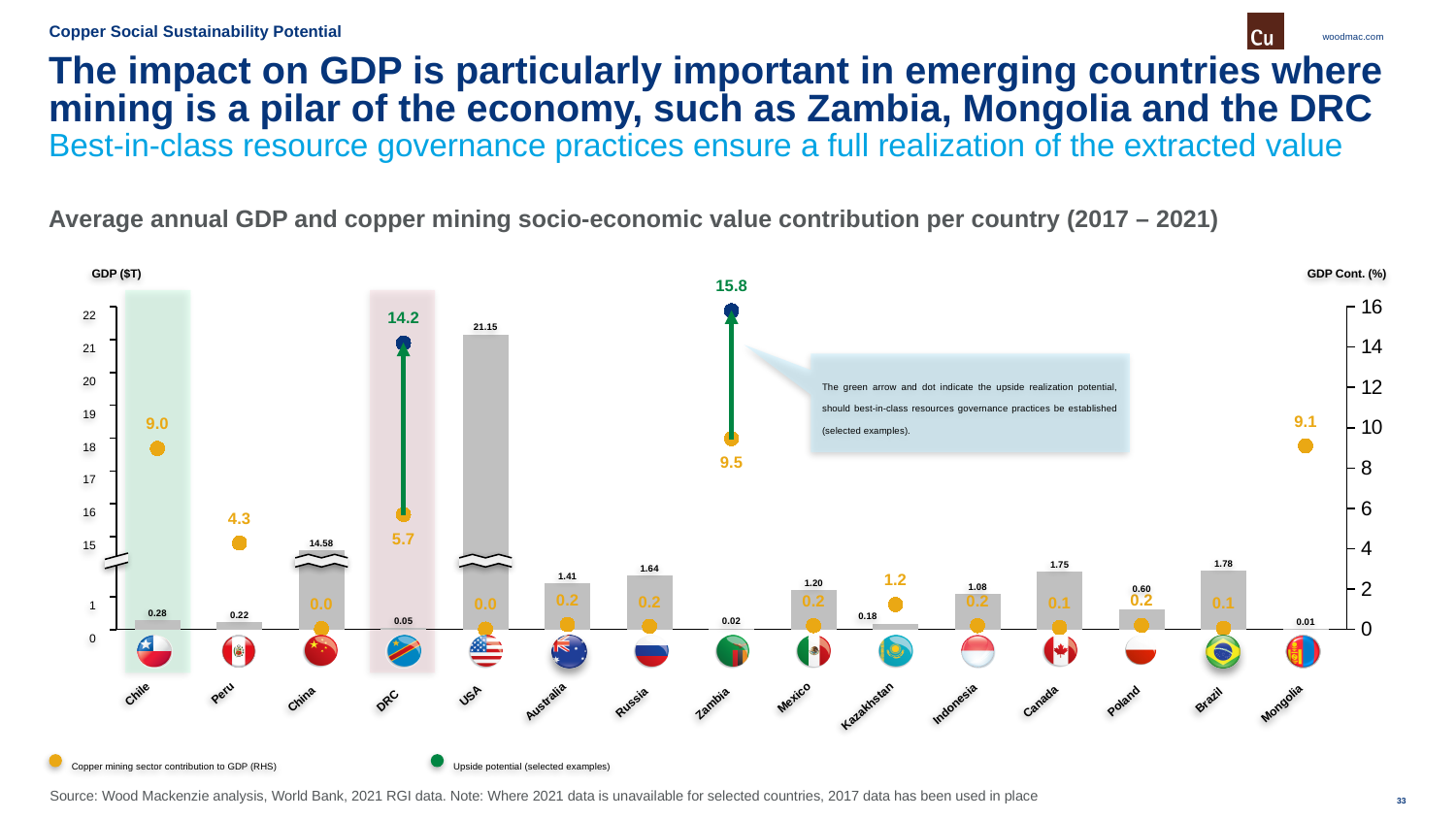
What is the copper mining sector contribution to GDP (%) shown for Peru? 4.3 What is the copper mining sector contribution to GDP (%) shown for Mongolia? 9.1 How many entries does the chart legend list? 2 What is the average annual GDP ($T) shown for the USA? 21.15 Which country has the lowest GDP ($T) bar? Mongolia What is the difference between Zambia's upside potential (15.8) and its current copper mining contribution to GDP (9.5)? 6.3 Which country has the highest GDP ($T) bar? USA What is the difference between the DRC's upside potential (14.2) and its current copper mining contribution to GDP (5.7)? 8.5 Which has the larger GDP ($T) bar, China or the USA? USA Which country has the highest current copper mining sector contribution to GDP (orange dot)? Zambia What is the GDP ($T) value shown for Kazakhstan? 0.18 How many countries are shown on the x axis of the chart? 15